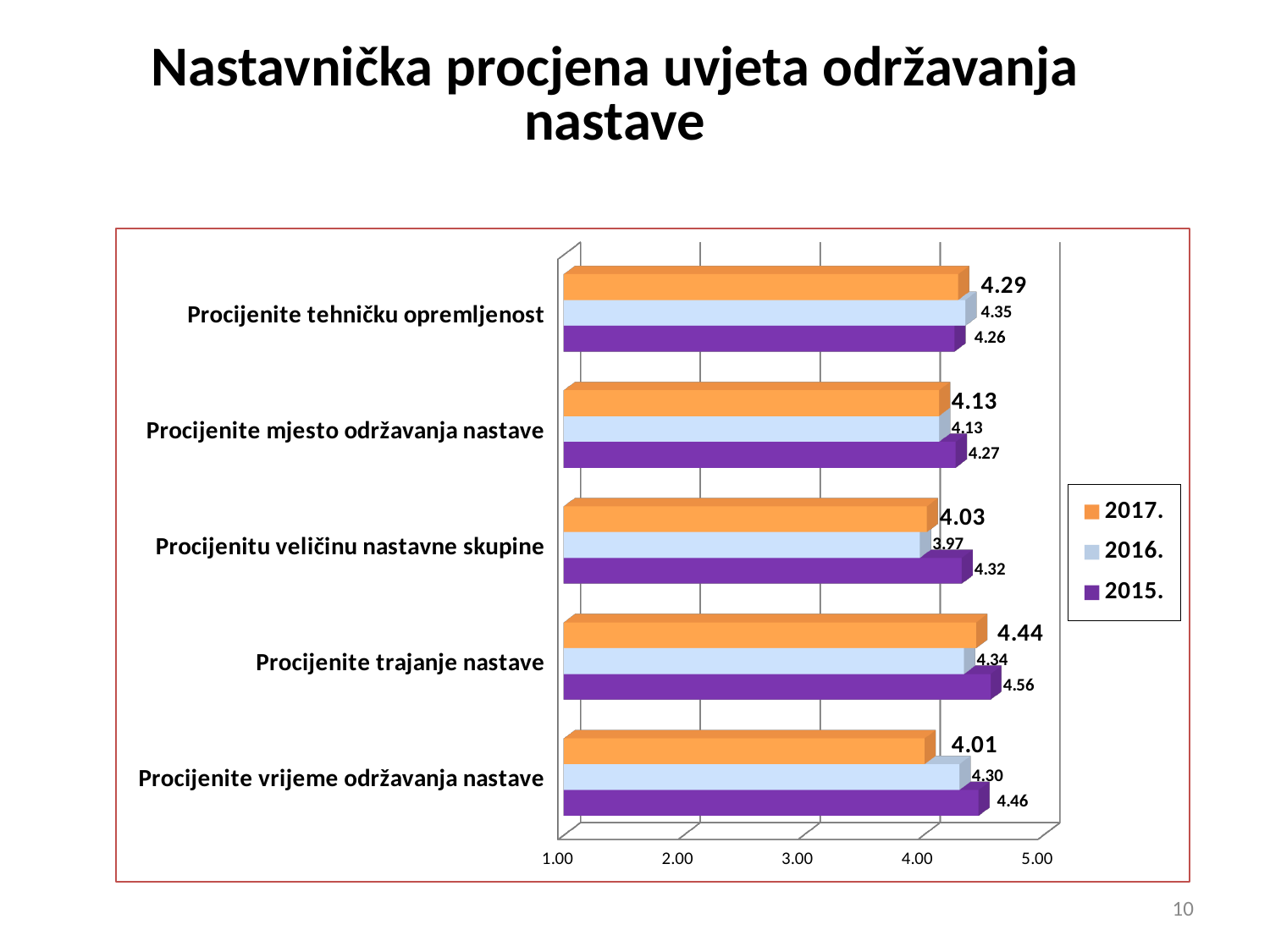
How many categories are shown on the chart? 5 Which colour represents the 2015. series? purple What is the difference between the 2015. and 2017. values for Procijenite vrijeme održavanja nastave? 0.45 What is the 2016. value for Procijenite vrijeme održavanja nastave? 4.30 How many series does the legend list? 3 Is the 2016. value for Procijenitu veličinu nastavne skupine greater or less than 4.00? less What is the 2017. value for Procijenite trajanje nastave? 4.44 Which is larger for Procijenite tehničku opremljenost: the 2016. value or the 2015. value? 2016. Which category has the lowest 2016. value? Procijenitu veličinu nastavne skupine Which category has the highest 2017. value? Procijenite trajanje nastave What is the 2015. value for Procijenitu veličinu nastavne skupine? 4.32 What kind of chart is shown on the slide? bar chart